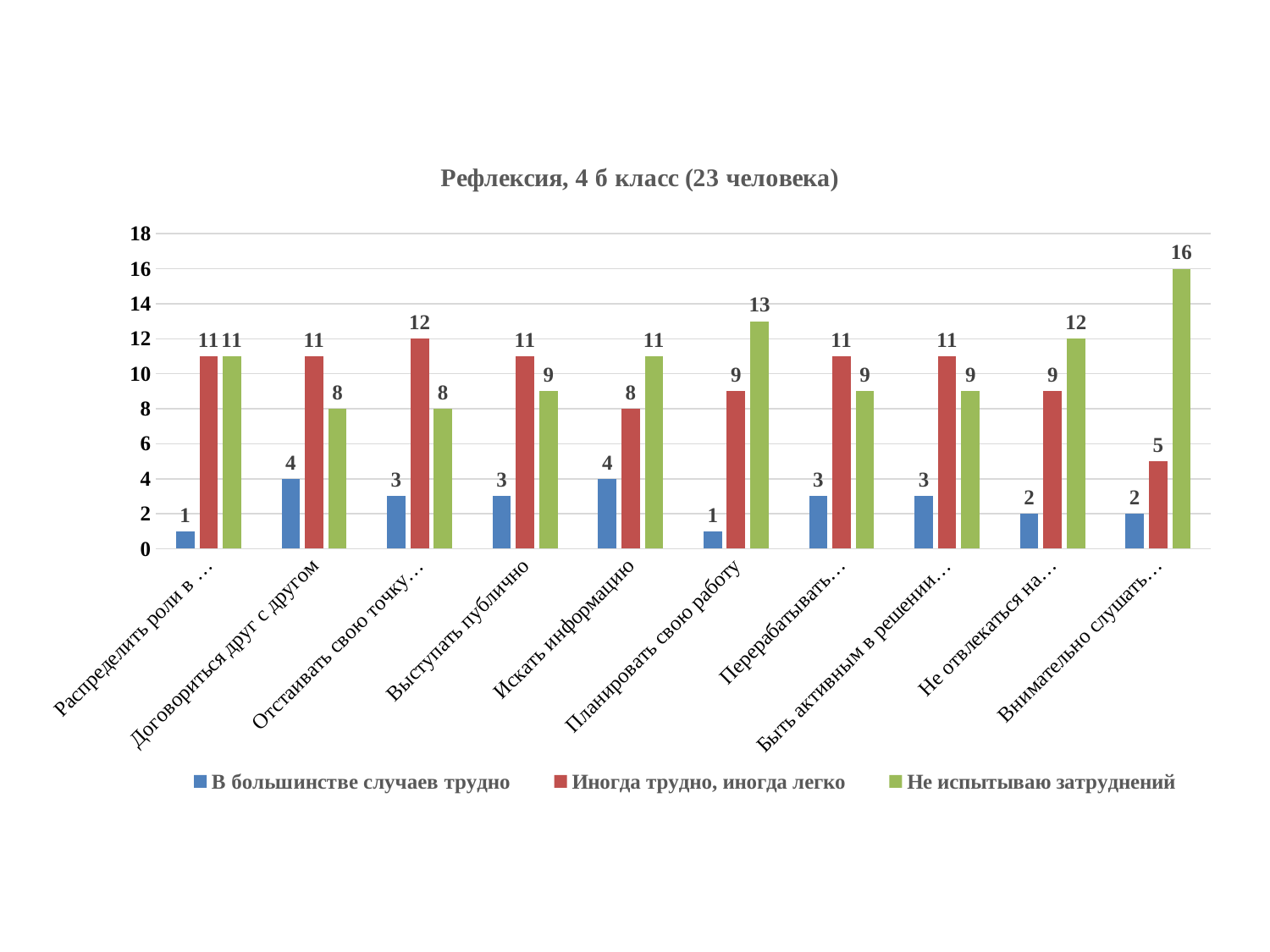
What is the difference between 'Не испытываю затруднений' and 'Иногда трудно, иногда легко' for 'Планировать свою работу'? 4 How many categories are shown on the x axis? 10 For 'Искать информацию', which is larger: 'Не испытываю затруднений' or 'Иногда трудно, иногда легко'? Не испытываю затруднений Which category has the highest value for 'Не испытываю затруднений'? Внимательно слушать… Which colour represents the series 'Не испытываю затруднений'? green How many series does the legend list? 3 What is the total of the three series for 'Выступать публично'? 23 What is the value of 'Иногда трудно, иногда легко' for 'Искать информацию'? 8 What is the title of the chart? Рефлексия, 4 б класс (23 человека) What is the value of 'Не испытываю затруднений' for 'Выступать публично'? 9 What type of chart is shown on the slide? bar chart What is the value of 'В большинстве случаев трудно' for 'Договориться друг с другом'? 4